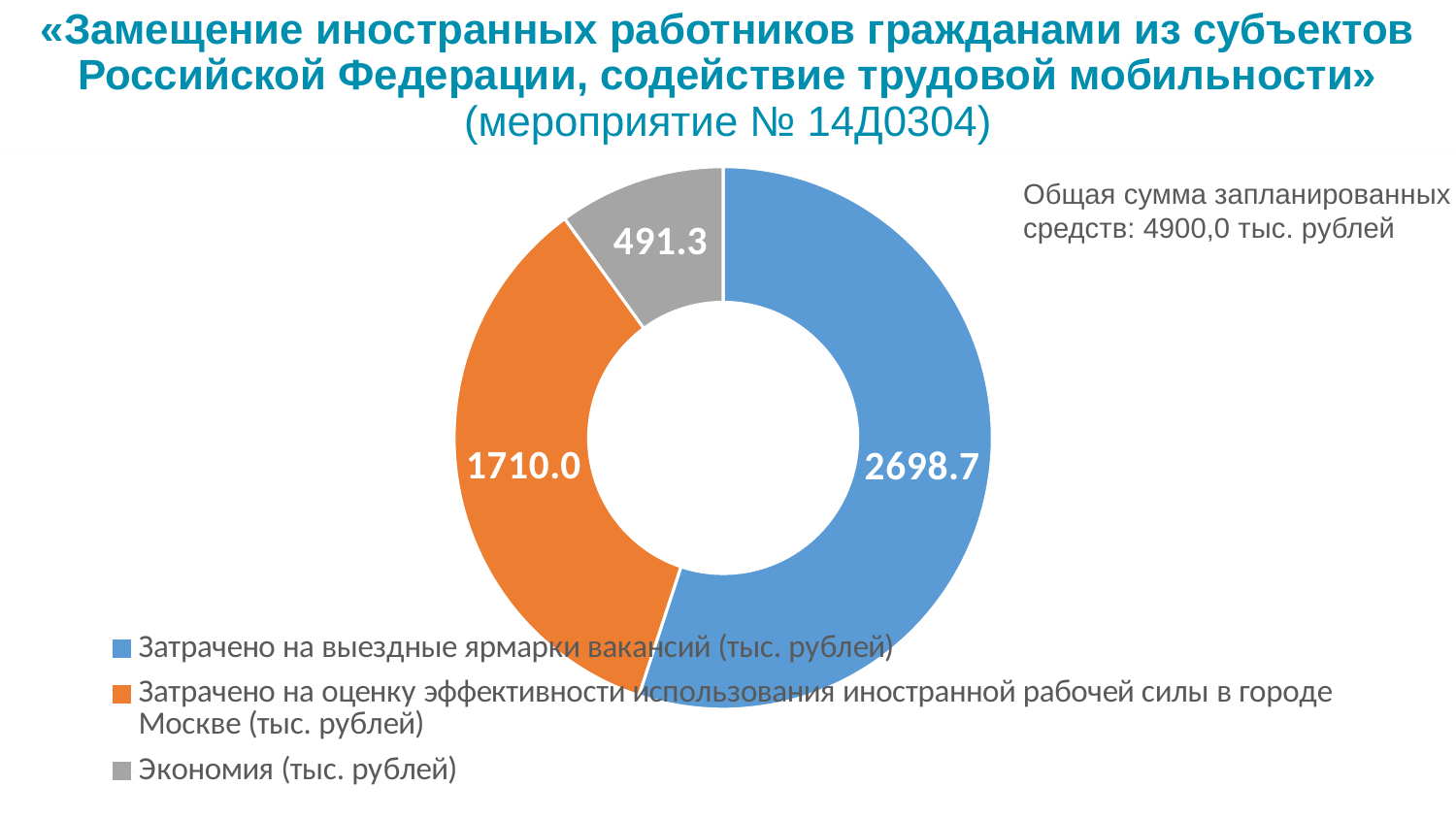
Which is larger: the value for «Экономия» or the value for «Затрачено на оценку эффективности использования иностранной рабочей силы в городе Москве»? Затрачено на оценку эффективности использования иностранной рабочей силы в городе Москве How many categories does the chart show? 3 What type of chart is shown on the slide? Doughnut (pie) chart Which category has the smallest slice? Экономия (тыс. рублей) Which category has the largest slice? Затрачено на выездные ярмарки вакансий (тыс. рублей) What is the difference between the value for «Затрачено на оценку эффективности использования иностранной рабочей силы в городе Москве» and the value for «Экономия»? 1218.7 What is the difference between the value for «Затрачено на выездные ярмарки вакансий» and the value for «Затрачено на оценку эффективности использования иностранной рабочей силы в городе Москве»? 988.7 What is the value for «Затрачено на оценку эффективности использования иностранной рабочей силы в городе Москве (тыс. рублей)»? 1710.0 What colour is the slice for «Экономия (тыс. рублей)»? Grey What is the value for «Экономия (тыс. рублей)»? 491.3 What is the total of all three slices? 4900.0 What is the value for «Затрачено на выездные ярмарки вакансий (тыс. рублей)»? 2698.7